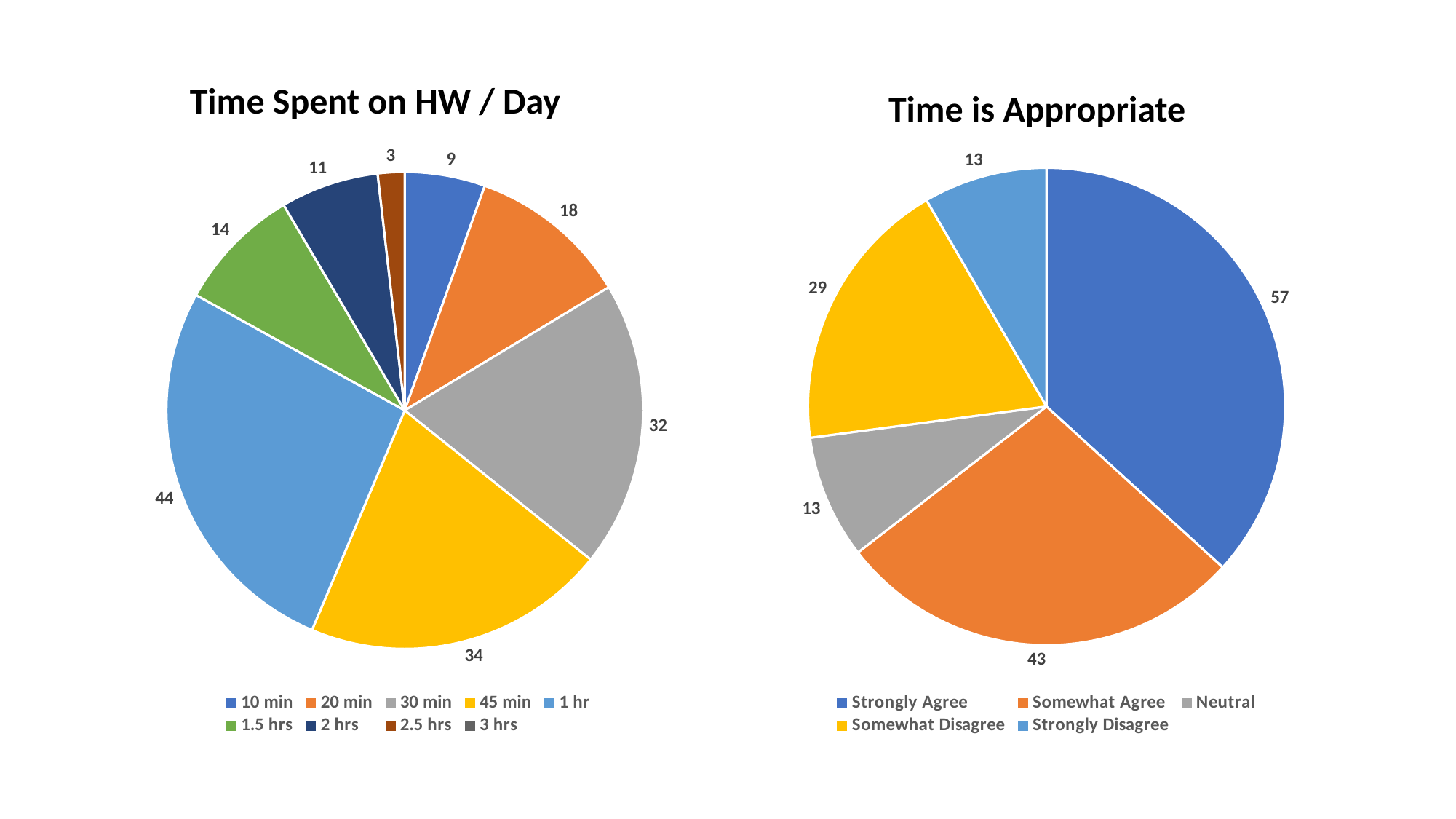
In the 'Time Spent on HW / Day' chart, which is larger, 1.5 hrs or 2 hrs? 1.5 hrs What type of chart is the 'Time is Appropriate' chart? Pie chart In the 'Time Spent on HW / Day' chart, what is the difference between the values for 45 min and 20 min? 16 In the 'Time is Appropriate' chart, which category has the largest slice? Strongly Agree In the 'Time Spent on HW / Day' chart, which labelled category has the smallest slice? 2.5 hrs In the 'Time Spent on HW / Day' chart, which category has the largest slice? 1 hr How many entries does the legend of the 'Time Spent on HW / Day' chart list? 9 In the 'Time Spent on HW / Day' chart, what is the value for 30 min? 32 In the 'Time Spent on HW / Day' chart, what is the value for 1 hr? 44 In the 'Time is Appropriate' chart, what is the value for Somewhat Disagree? 29 How many slices does the 'Time is Appropriate' chart have? 5 In the 'Time is Appropriate' chart, what is the difference between Strongly Agree and Somewhat Agree? 14